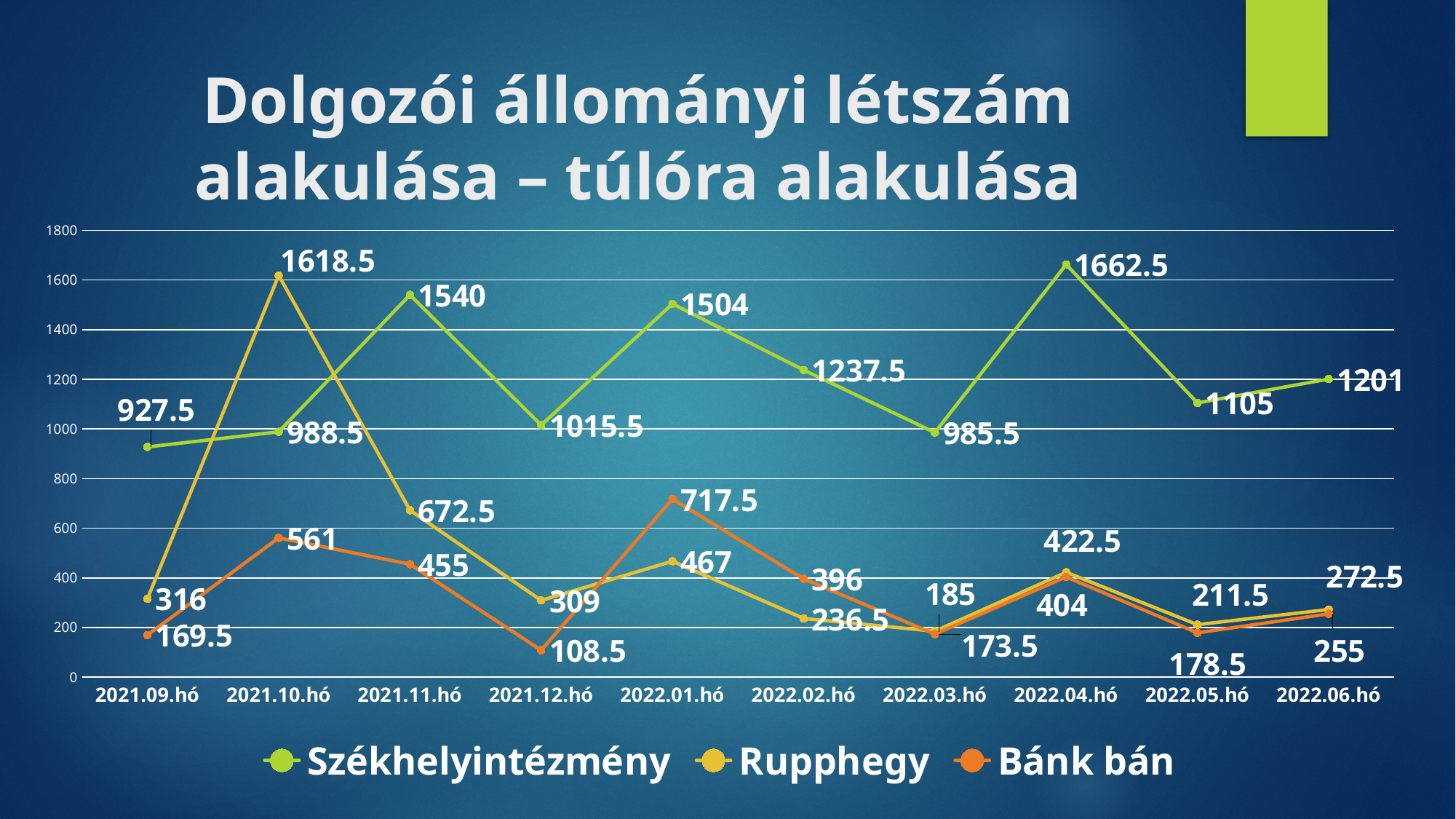
In which month does Bánk bán have its lowest value? 2021.12.hó What is the value for Rupphegy in 2021.10.hó? 1618.5 In which month does Székhelyintézmény reach its highest value? 2022.04.hó What is the value for Székhelyintézmény in 2022.04.hó? 1662.5 In 2021.10.hó, which series has the larger value, Rupphegy or Székhelyintézmény? Rupphegy How many series does the legend list? 3 How many months are plotted along the x axis? 10 What kind of chart is shown on the slide? line chart What is the difference between the Székhelyintézmény values for 2022.04.hó and 2022.05.hó? 557.5 Which colour is used for the Bánk bán series? orange In which month does Rupphegy have its lowest value? 2022.03.hó What is the value for Bánk bán in 2022.01.hó? 717.5